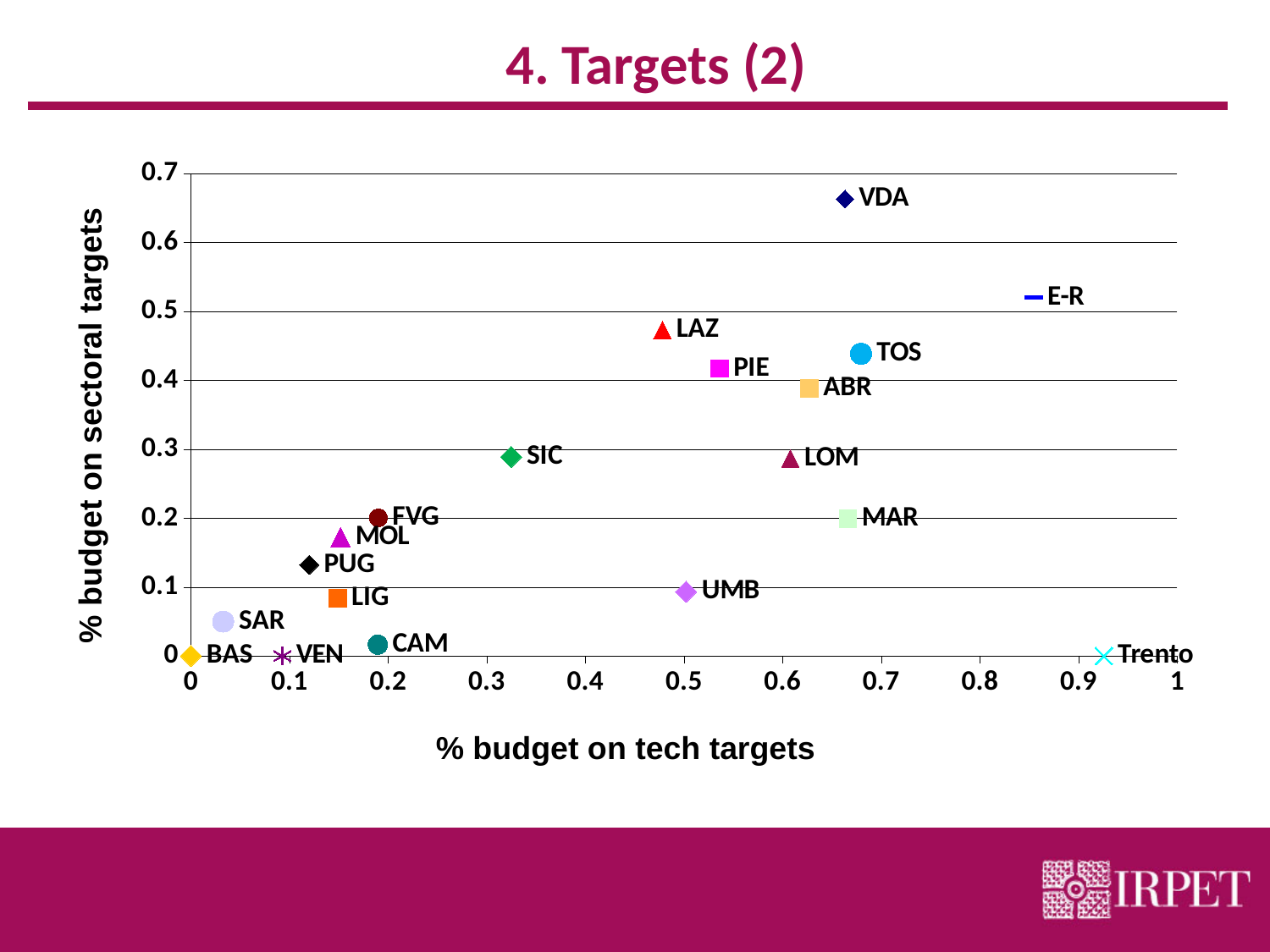
Which has a higher % budget on sectoral targets, LAZ or PIE? LAZ How many labelled data points are plotted on the chart? 19 Is the % budget on tech targets for SIC greater or less than 0.4? less Which region has the highest % budget on tech targets? Trento Is the % budget on sectoral targets for VDA greater or less than 0.6? greater Is the % budget on tech targets for SAR greater or less than 0.1? less Which region has the lowest % budget on tech targets? BAS What kind of chart is shown on the slide? scatter chart Which region has the highest % budget on sectoral targets? VDA What is the title of the horizontal axis? % budget on tech targets Which has a higher % budget on tech targets, SIC or LOM? LOM